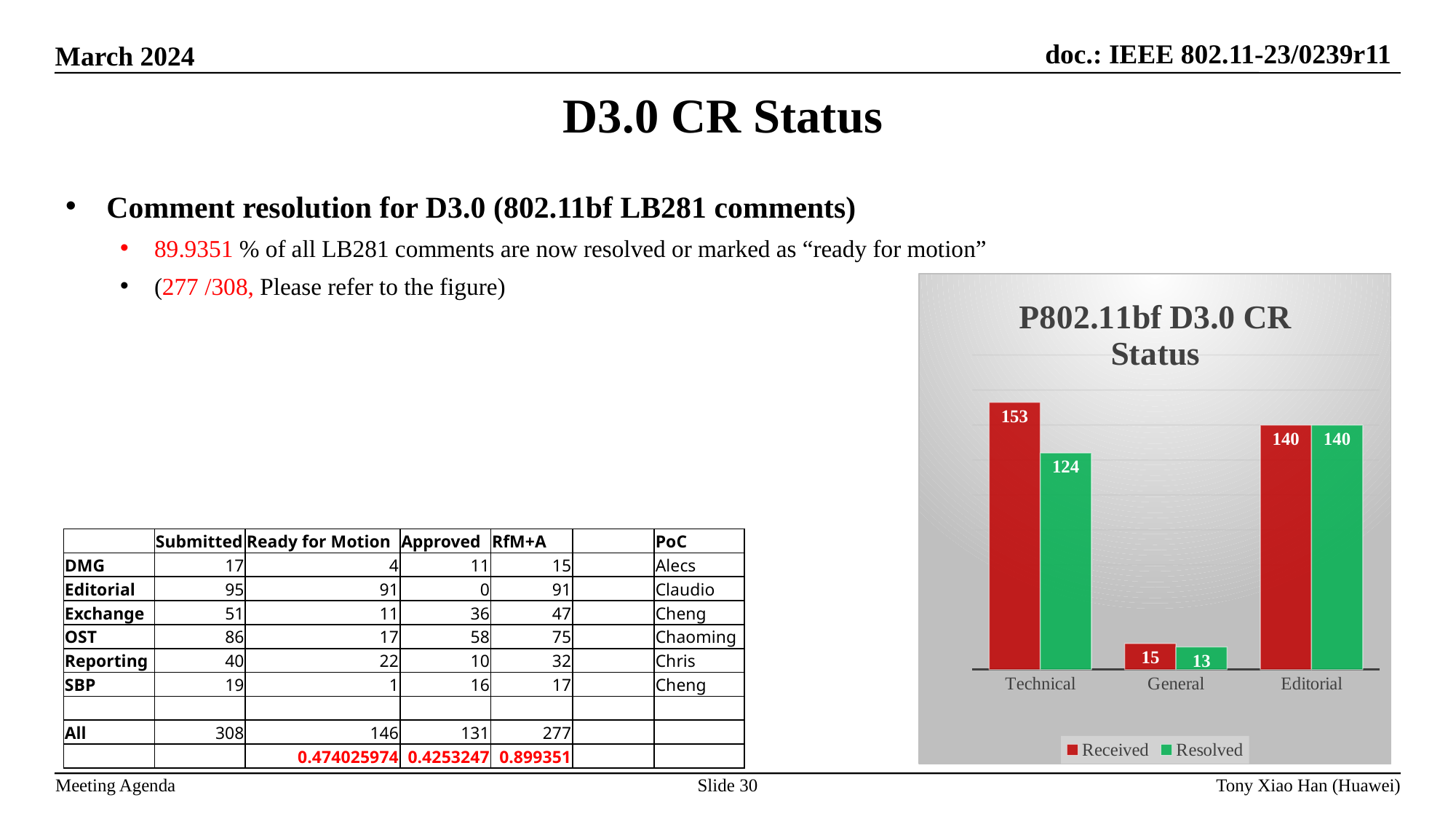
How many categories are shown on the x axis? 3 What is the Received value for Technical? 153 What is the Resolved value for Technical? 124 Which category has the lowest Resolved value? General What is the Resolved value for Editorial? 140 Which category has the highest Received value? Technical Which is larger for General, Received or Resolved? Received What is the difference between Received and Resolved for Technical? 29 What is the title of the chart? P802.11bf D3.0 CR Status How many series does the legend list? 2 What kind of chart is shown? bar chart What is the Received value for General? 15